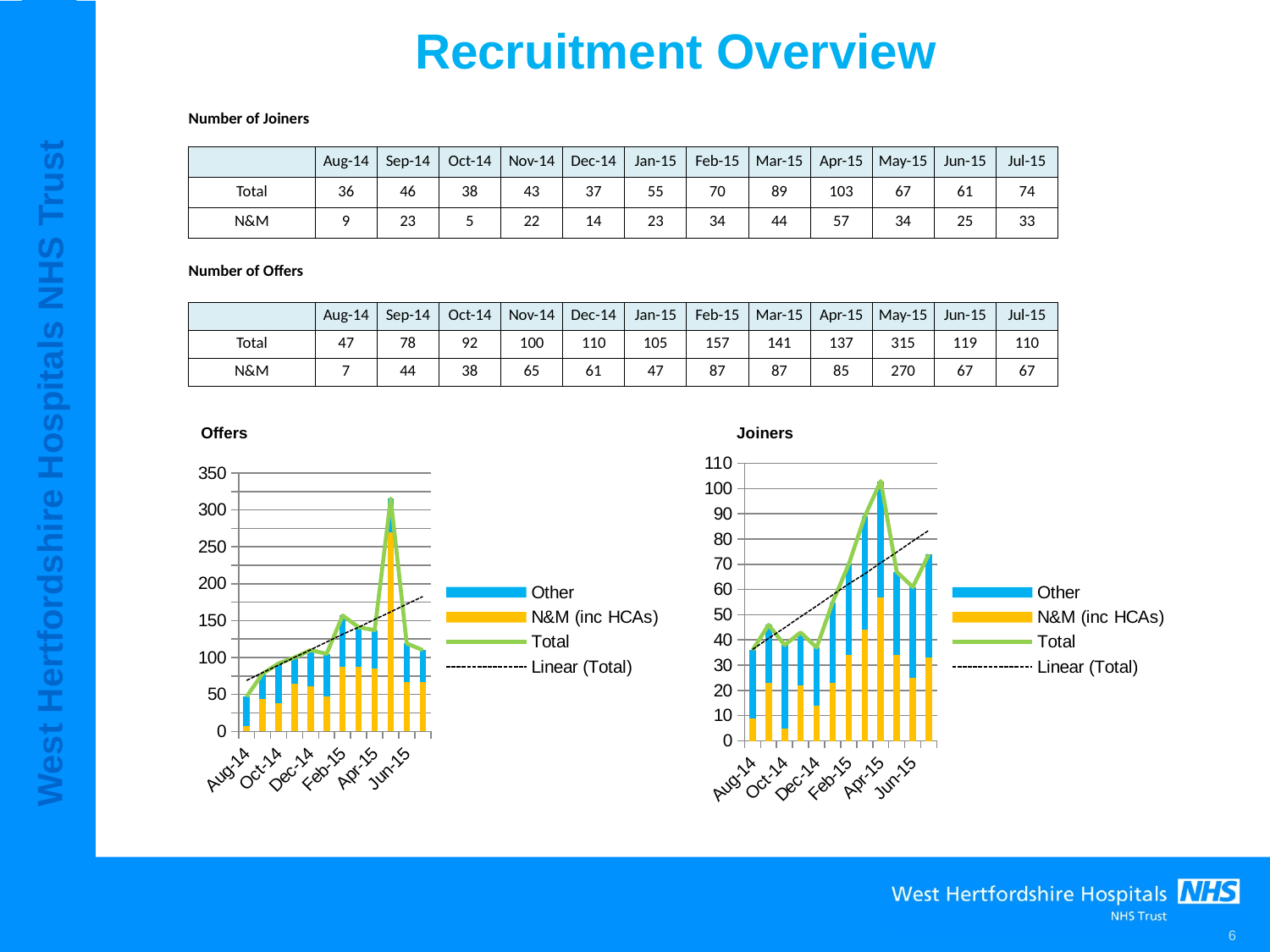
In the Joiners chart, is the total for Apr-15 greater or less than 100? greater How many entries does the legend of the Offers chart list? 4 In the Offers chart, is the total for May-15 greater or less than 300? greater In the Offers chart, which month has the highest total? May-15 In the Offers chart, which month has the lowest total? Aug-14 According to the Number of Offers table, what is the total number of offers in May-15? 315 In the Joiners chart, which month has the highest total? Apr-15 What kind of chart is the Offers chart? combination bar and line chart In the Joiners chart, which month has the larger total, Feb-15 or Mar-15? Mar-15 Using the Number of Offers table, what is the difference between the total offers in May-15 and Jun-15? 196 In the Joiners chart, does the Linear (Total) trend line rise or fall from Aug-14 to Jul-15? rise How many months are plotted on the x axis of the Joiners chart? 12